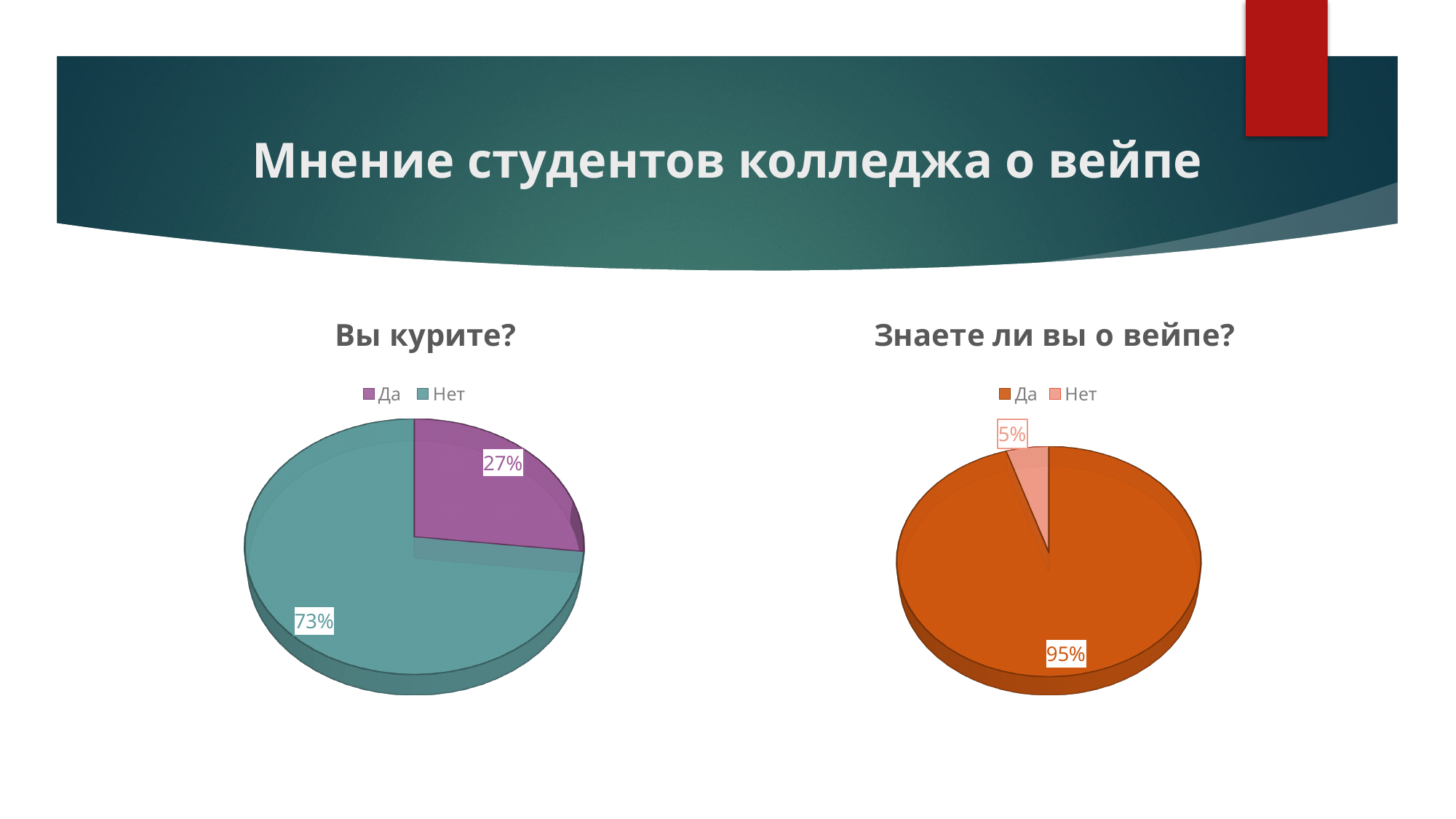
In the 'Вы курите?' chart, what is the difference in percentage points between 'Нет' and 'Да'? 46 In the 'Вы курите?' chart, what share of respondents answered 'Да'? 27% In the 'Знаете ли вы о вейпе?' chart, what is the difference in percentage points between 'Да' and 'Нет'? 90 What type of chart is used for 'Знаете ли вы о вейпе?'? Pie chart In the 'Вы курите?' chart, what share of respondents answered 'Нет'? 73% Which is larger in the 'Вы курите?' chart: the 'Да' slice or the 'Нет' slice? Нет In the 'Вы курите?' chart, which answer has the largest slice? Нет In the 'Знаете ли вы о вейпе?' chart, what share of respondents answered 'Да'? 95% What is the title of the chart on the left side of the slide? Вы курите? In the 'Знаете ли вы о вейпе?' chart, what share of respondents answered 'Нет'? 5% In the 'Знаете ли вы о вейпе?' chart, which answer has the smallest slice? Нет How many slices does the 'Вы курите?' pie chart have? 2